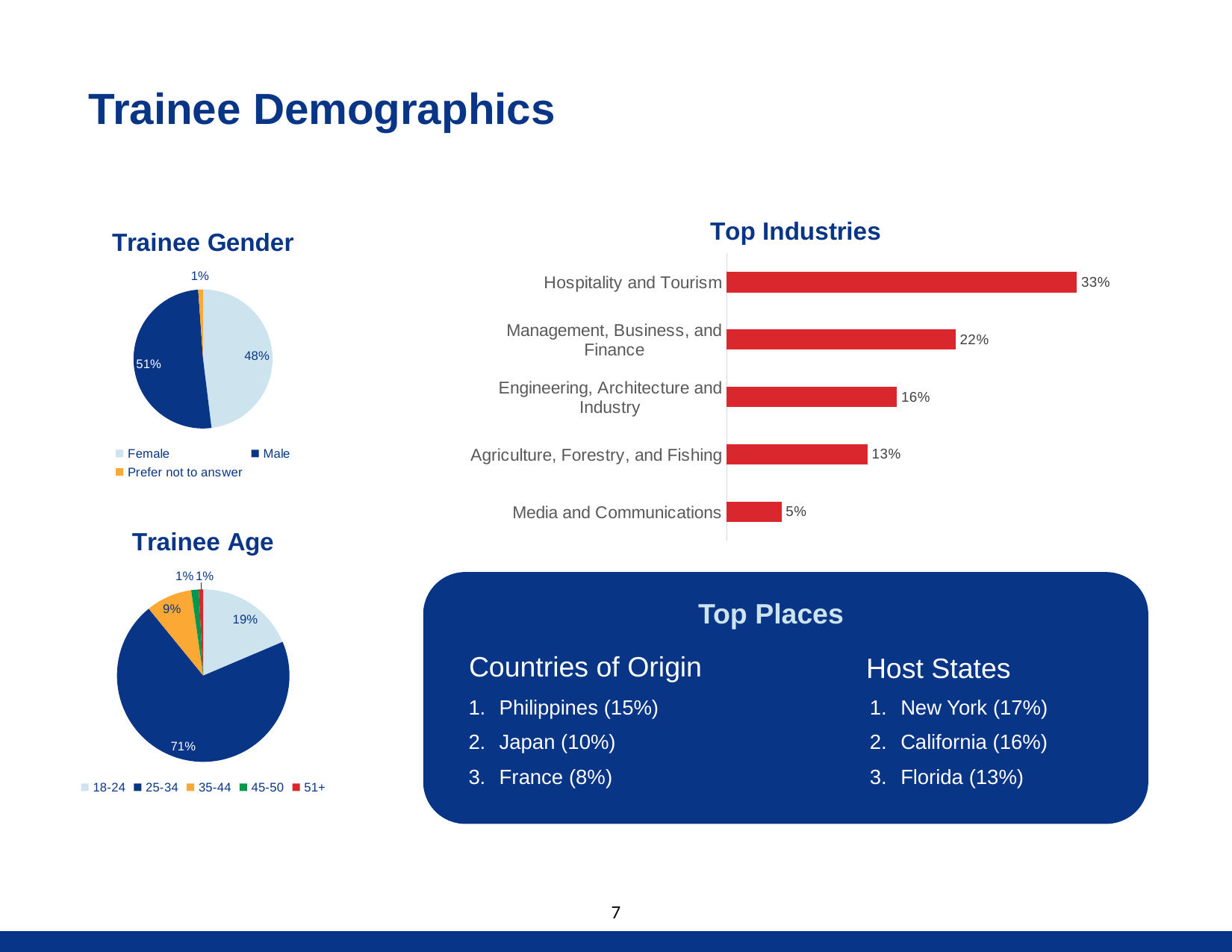
What kind of chart is the Top Industries chart? Bar chart In the Top Industries chart, which industry has the lowest value? Media and Communications In the Trainee Gender chart, what share of trainees are Male? 51% In the Top Industries chart, what is the value for Hospitality and Tourism? 33% In the Top Industries chart, what is the difference between Management, Business, and Finance and Engineering, Architecture and Industry? 6% In the Trainee Gender chart, which is larger, Female or Male? Male In the Trainee Age chart, what is the value for the 35-44 age group? 9% In the Top Industries chart, what is the value for Agriculture, Forestry, and Fishing? 13% How many categories does the legend of the Trainee Gender chart list? 3 In the Top Industries chart, how many industries are shown? 5 In the Trainee Age chart, what share of trainees are aged 25-34? 71% What kind of chart is the Trainee Age chart? Pie chart